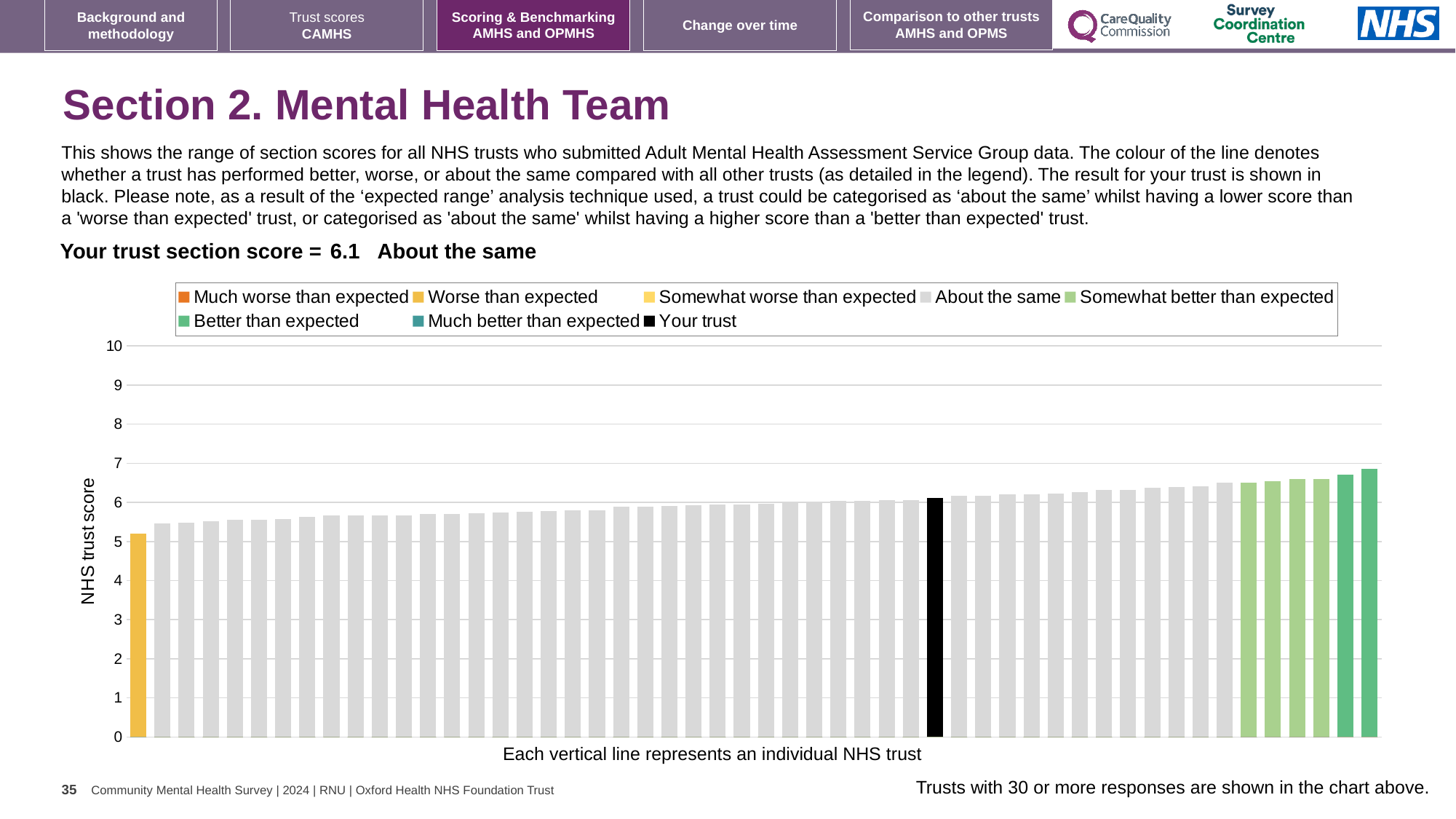
What is your trust's section score for Mental Health Team? 6.1 Is the value of the leftmost (lowest) bar greater or less than 6? less Is the value for your trust greater or less than 5? greater What kind of chart is shown on the slide? bar chart Which is larger: the value for your trust (black bar) or the value of the leftmost yellow bar? your trust What is the label on the vertical axis of the chart? NHS trust score What colour is the bar representing your trust? black Is the value of the rightmost (highest) bar greater or less than 6? greater Which category is your trust placed in for this section? About the same How many entries does the chart legend list? 8 Do the bar values rise or fall from left to right along the x axis? rise